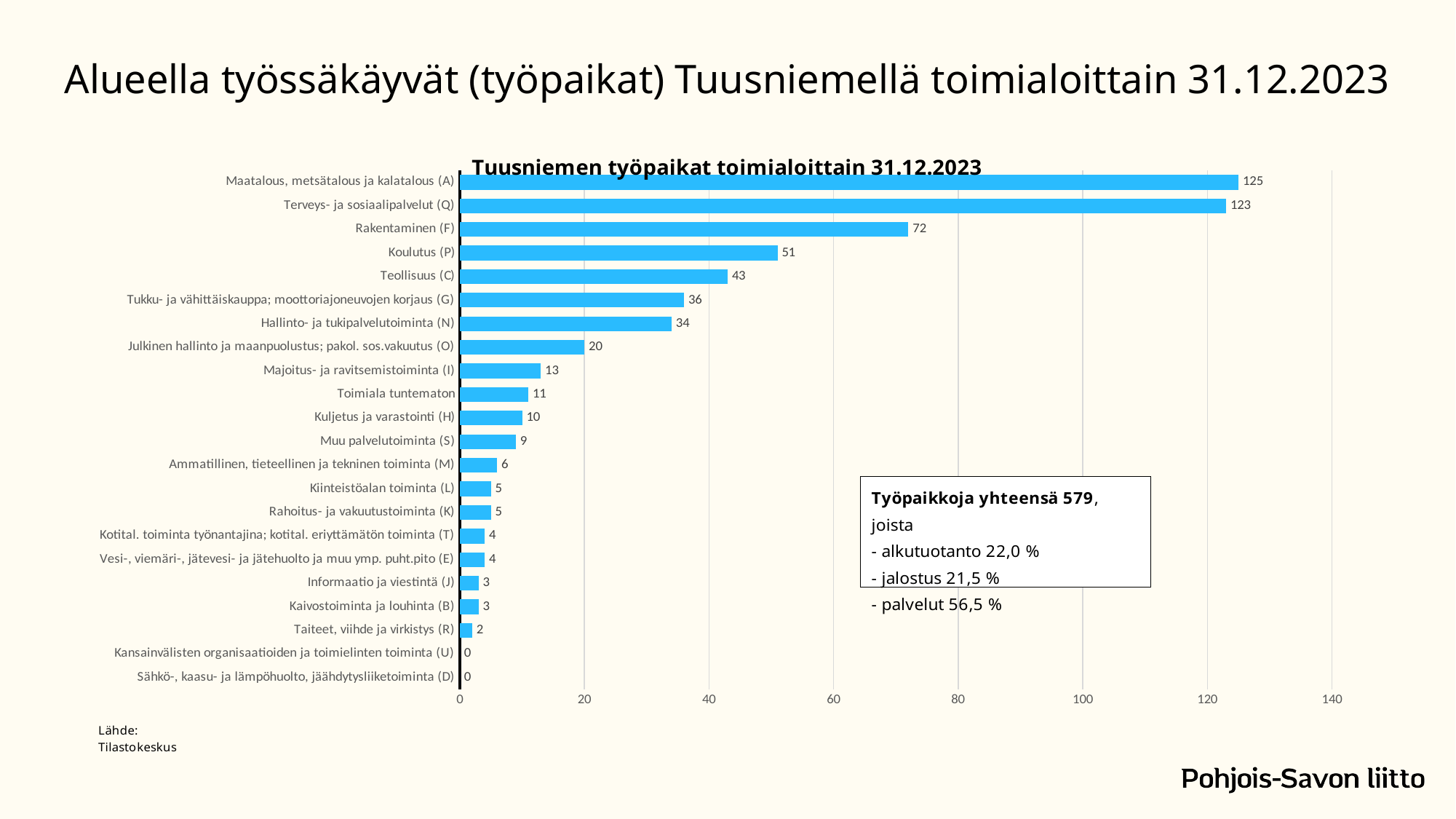
What kind of chart is shown on the slide? Bar chart What is the value for Julkinen hallinto ja maanpuolustus; pakol. sos.vakuutus (O)? 20 What is the difference between Rakentaminen (F) and Teollisuus (C)? 29 What is the value for Rakentaminen (F)? 72 Is the value for Koulutus (P) greater or less than 40? greater Which category has the highest value? Maatalous, metsätalous ja kalatalous (A) What is the title of the chart? Tuusniemen työpaikat toimialoittain 31.12.2023 What is the value for Koulutus (P)? 51 Which is larger, Tukku- ja vähittäiskauppa; moottoriajoneuvojen korjaus (G) or Hallinto- ja tukipalvelutoiminta (N)? Tukku- ja vähittäiskauppa; moottoriajoneuvojen korjaus (G) What is the value for Toimiala tuntematon? 11 How many categories are shown in the chart? 22 What is the difference between Maatalous, metsätalous ja kalatalous (A) and Terveys- ja sosiaalipalvelut (Q)? 2